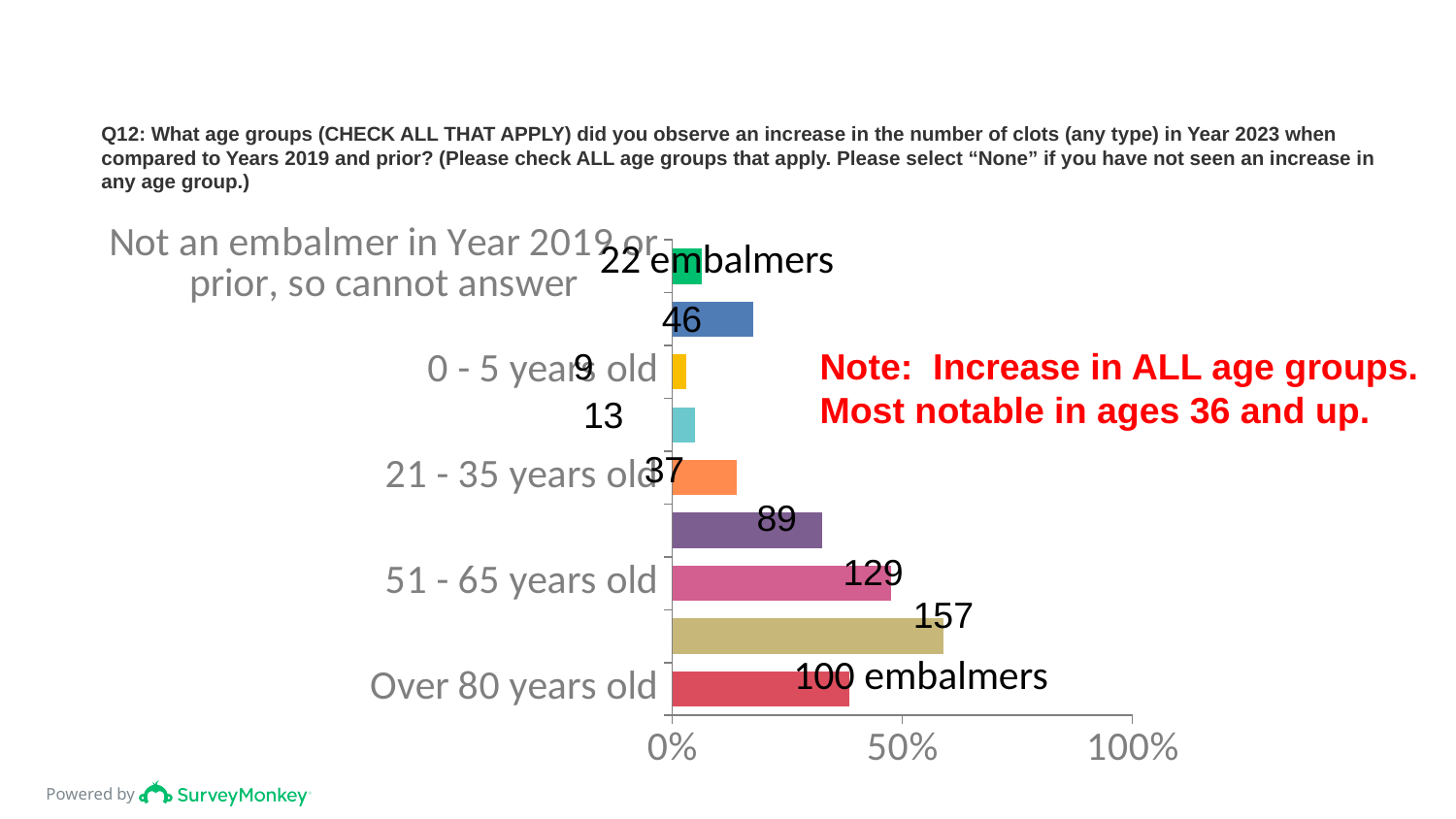
What is the difference between the values for '51 - 65 years old' (129) and 'Over 80 years old' (100)? 29 How many bars are plotted in the chart? 9 What is the value labelled on the bar for 'Not an embalmer in Year 2019 or prior, so cannot answer'? 22 embalmers What is the largest data label value shown on any bar in the chart? 157 What is the value labelled on the bar for '51 - 65 years old'? 129 Is the bar for 'Over 80 years old' greater or less than 50% on the axis? less What is the value labelled on the bar for '0 - 5 years old'? 9 What is the value labelled on the bar for '21 - 35 years old'? 37 Which has the larger value: '51 - 65 years old' or 'Over 80 years old'? 51 - 65 years old What is the value labelled on the bar for 'Over 80 years old'? 100 embalmers What kind of chart is shown on the slide? bar chart Which labelled category has the lowest value in the chart? 0 - 5 years old